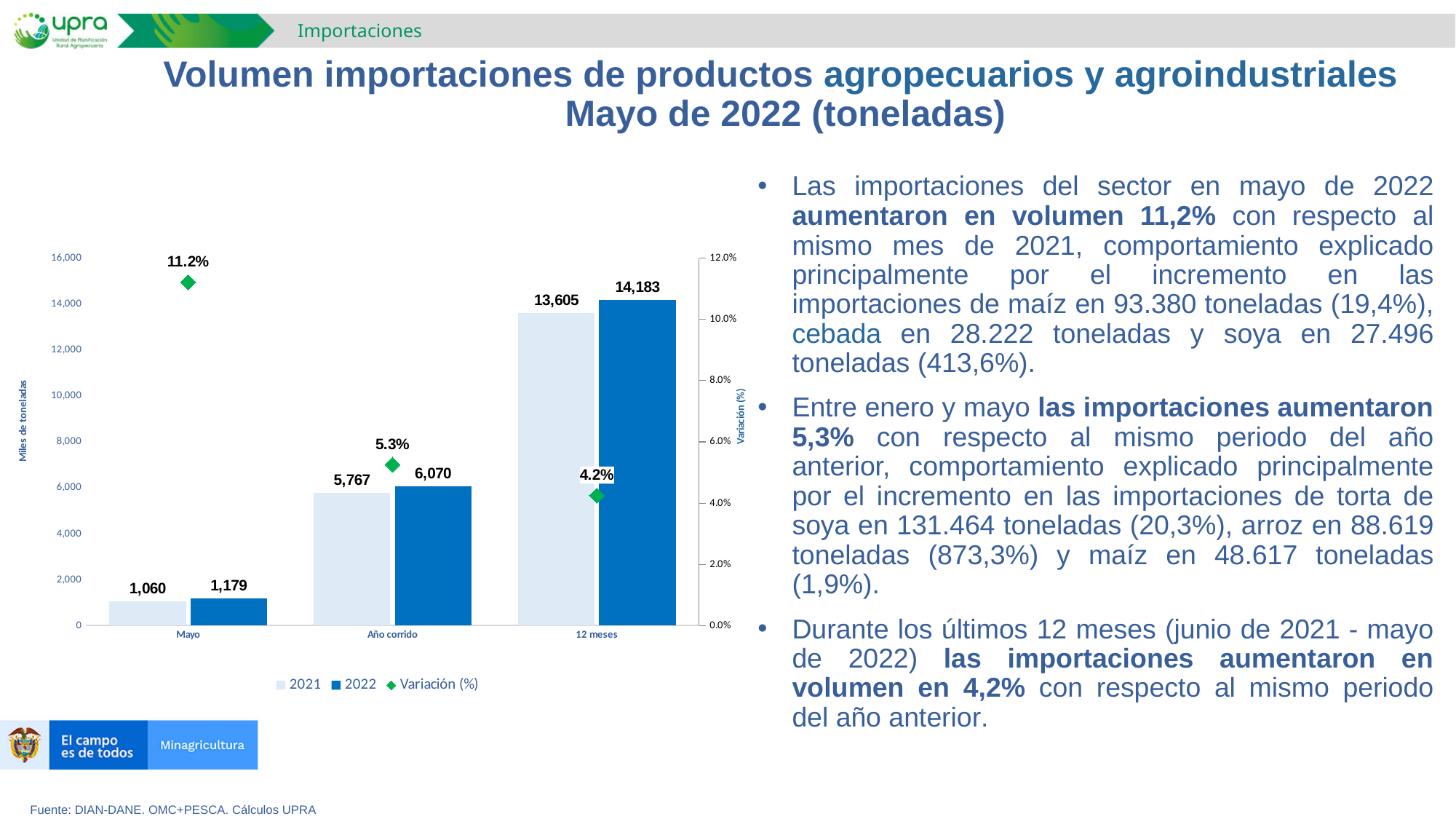
What is the label of the left vertical axis? Miles de toneladas Which category has the highest 2022 value? 12 meses What is the Variación (%) value for 12 meses? 4.2% Which is larger for Año corrido, the 2021 value or the 2022 value? 2022 What is the difference between the 2022 and 2021 values for 12 meses? 578 How many categories are shown on the x axis? 3 Which category has the lowest 2021 value? Mayo What is the 2022 value for Mayo? 1,179 How many series does the legend list? 3 Is the 2022 value for Año corrido greater or less than 8,000? less What is the 2021 value for Año corrido? 5,767 What kind of chart is used for the 2021 and 2022 series? bar chart